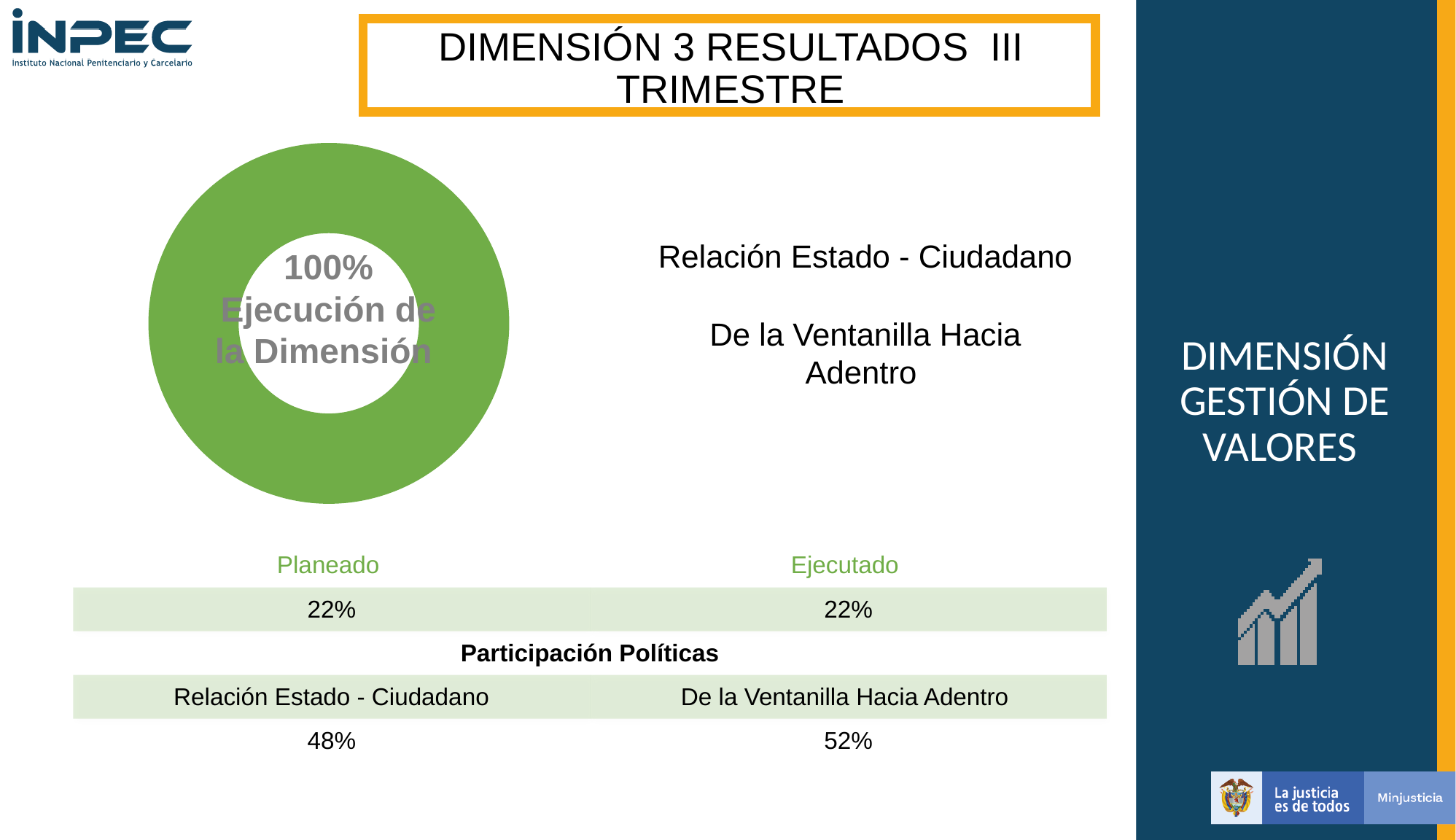
What share of the donut chart does the single green slice occupy? 100% What percentage is displayed in the centre of the donut chart? 100% What colour is the slice of the donut chart? Green What text label appears in the centre of the donut chart below the percentage? Ejecución de la Dimensión What kind of chart is shown on the left of the slide? Donut (pie) chart What value does the donut chart show for 'Ejecución de la Dimensión'? 100% How many slices does the donut chart contain? 1